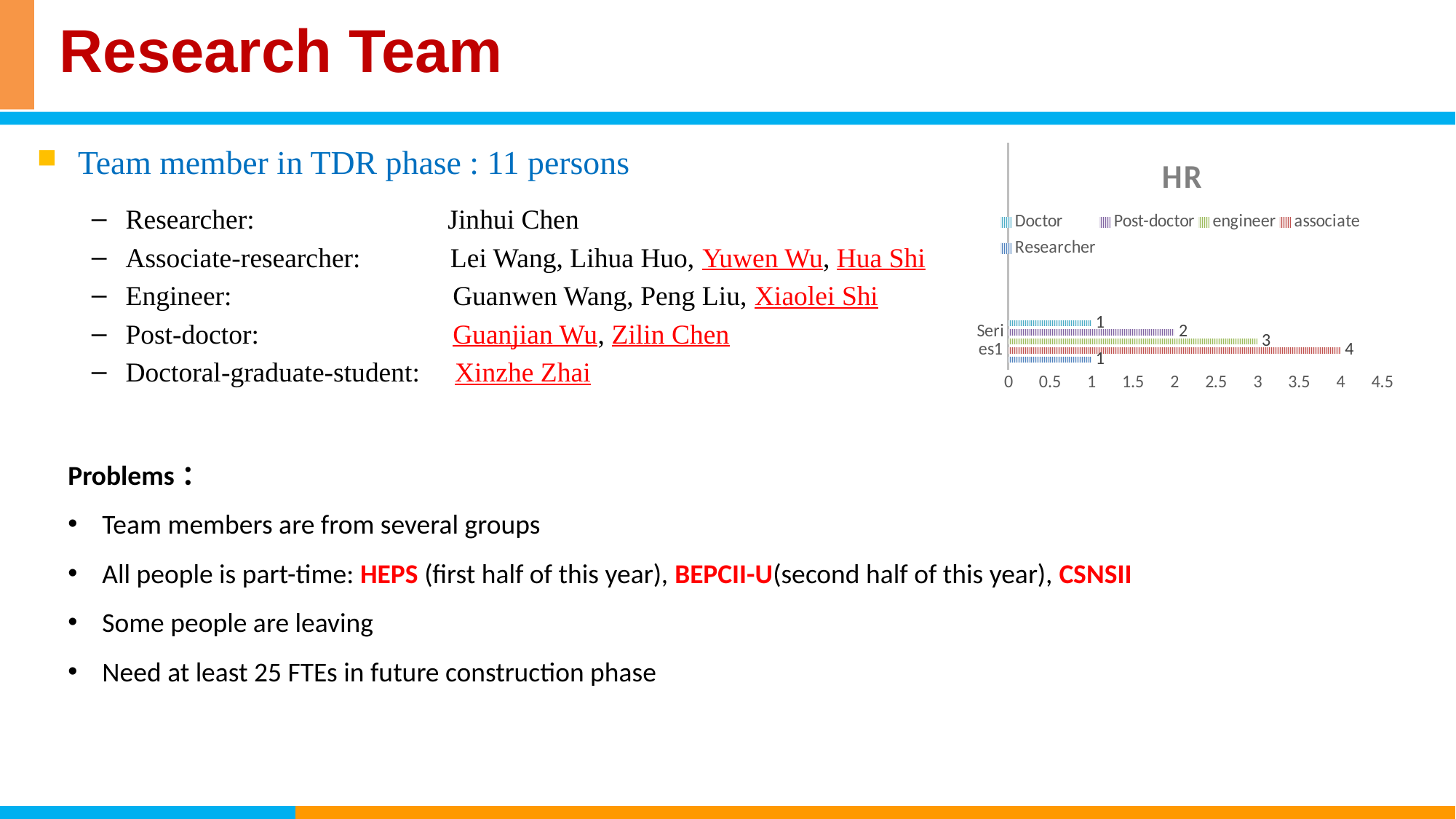
Which is larger in the HR chart, the engineer value or the Post-doctor value? engineer What is the value for the engineer series in the HR chart? 3 What is the difference between the associate and Post-doctor values in the HR chart? 2 What is the value for the Post-doctor series in the HR chart? 2 What is the maximum value shown on the x axis of the HR chart? 4.5 What is the title of the chart? HR Is the value for associate in the HR chart greater or less than 3.5? greater Which series has the highest value in the HR chart? associate What is the value for the Doctor series in the HR chart? 1 What is the value for the associate series in the HR chart? 4 How many series does the chart legend list? 5 What kind of chart is shown on the slide? bar chart